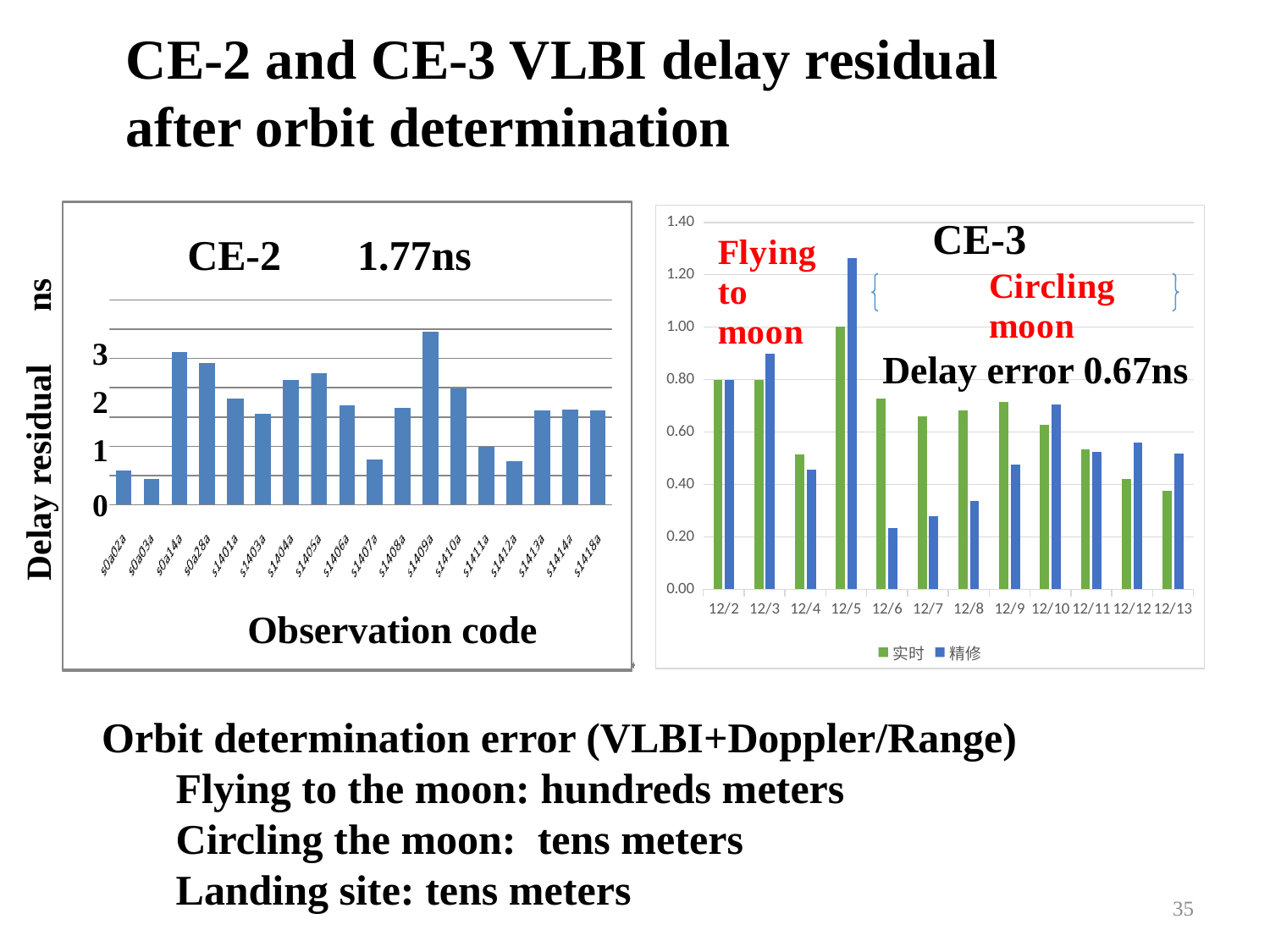
What kind of chart is the CE-2 chart on the left? bar chart In the CE-3 chart, is the 精修 value for 12/6 greater or less than 0.40? less In the CE-2 chart, which observation code has the lowest delay residual? s0a03a In the CE-3 chart, which is larger on 12/6, the 实时 value or the 精修 value? 实时 In the CE-3 chart, on which date does the 精修 series reach its highest value? 12/5 In the CE-2 chart, is the value for s1407a greater or less than 1? less In the CE-2 chart, which observation code has the highest delay residual? s1409a In the CE-2 chart, is the value for s1409a greater or less than 3? greater How many series does the legend of the CE-3 chart list? 2 How many observation codes are shown on the x axis of the CE-2 chart? 18 In the CE-2 chart, which is larger, the value for s0a14a or the value for s0a03a? s0a14a How many dates are shown on the x axis of the CE-3 chart? 12